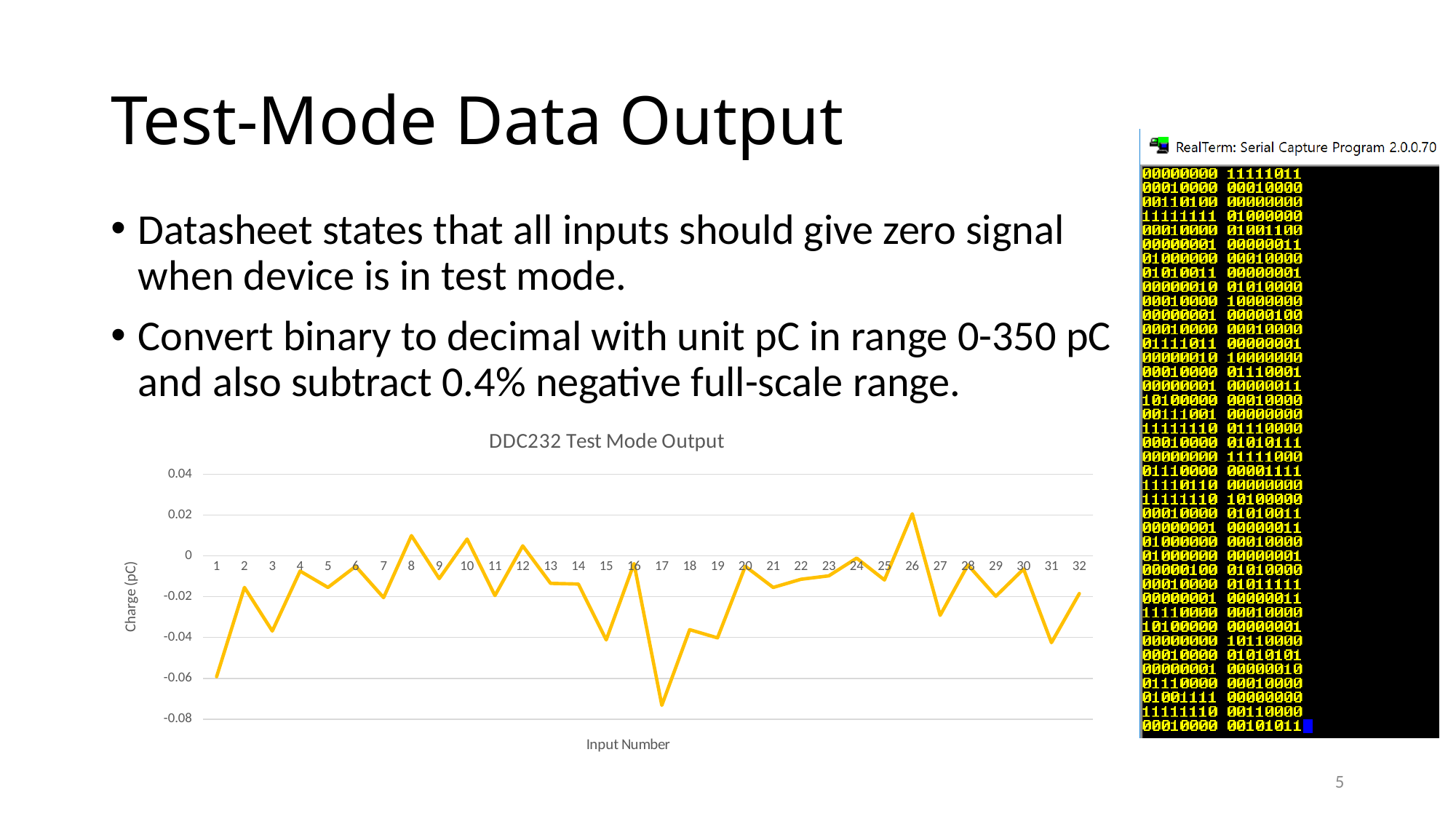
What is the title of the chart? DDC232 Test Mode Output Is the charge value for input number 26 greater or less than 0? greater What kind of chart is shown on the slide? line chart Is the charge value for input number 1 greater or less than -0.04? less Which has the larger charge value, input number 16 or input number 15? input number 16 Which input number has the lowest charge value in the chart? 17 How many input numbers are plotted along the x axis of the chart? 32 Is the charge value for input number 15 greater or less than -0.02? less Which has the larger charge value, input number 1 or input number 17? input number 1 What is the label of the vertical axis of the chart? Charge (pC) Which input number has the highest charge value in the chart? 26